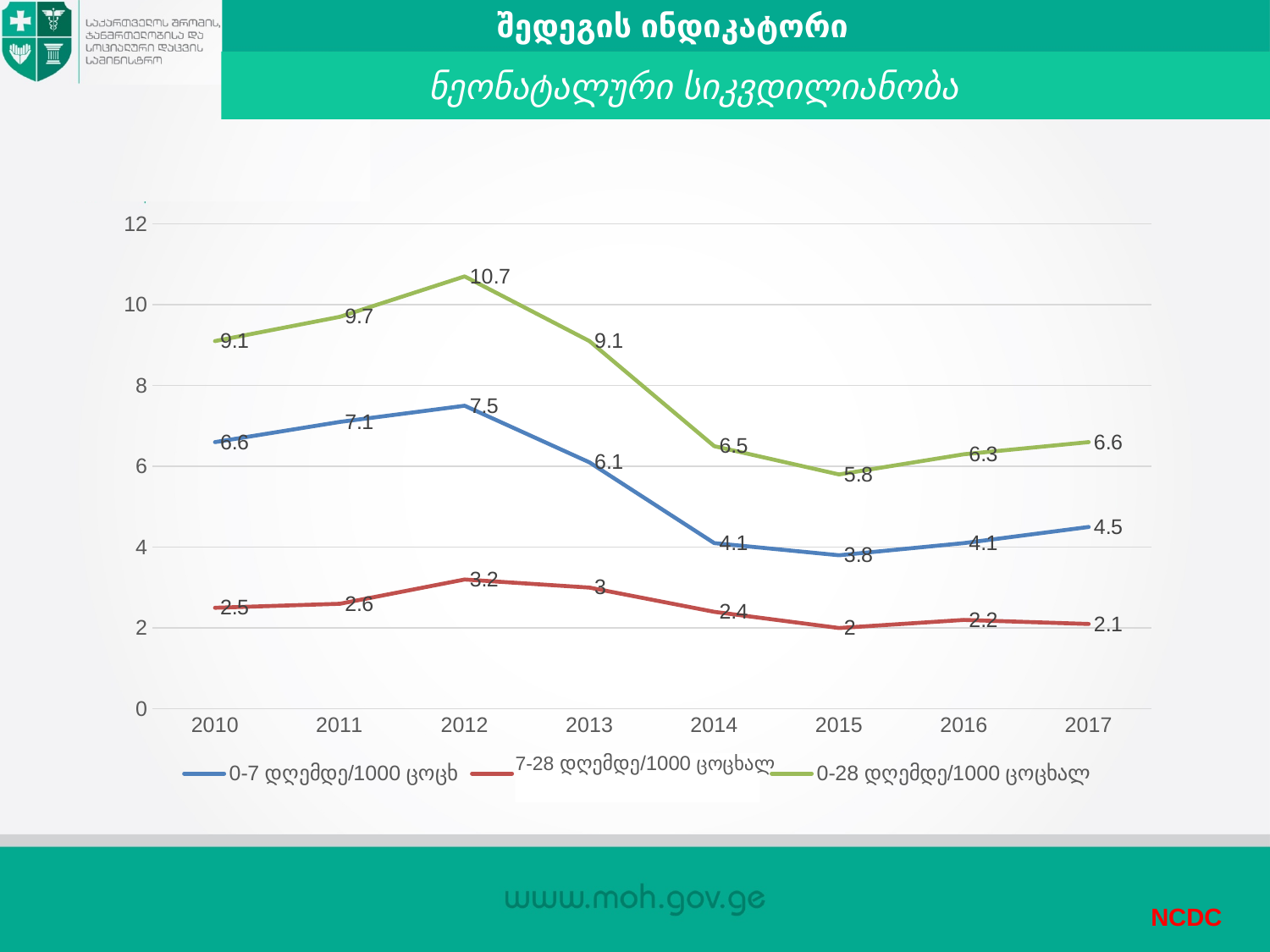
In which year does the red line (7-28 დღემდე/1000 ცოცხალ) reach its lowest value? 2015 How many series does the legend list? 3 What is the value of the blue line (0-7 დღემდე/1000 ცოცხ) in 2015? 3.8 Does the green line (0-28 დღემდე/1000 ცოცხალ) rise or fall between 2012 and 2015? fall In which year does the green line (0-28 დღემდე/1000 ცოცხალ) reach its highest value? 2012 How many years are shown on the x axis? 8 What is the value of the green line (0-28 დღემდე/1000 ცოცხალ) in 2012? 10.7 What is the difference between the green line's value in 2012 and its value in 2015? 4.9 What is the value of the red line (7-28 დღემდე/1000 ცოცხალ) in 2017? 2.1 Which series is drawn in green in the legend? 0-28 დღემდე/1000 ცოცხალ Which is larger: the blue line's value in 2010 or its value in 2017? 2010 What type of chart is shown on the slide? line chart